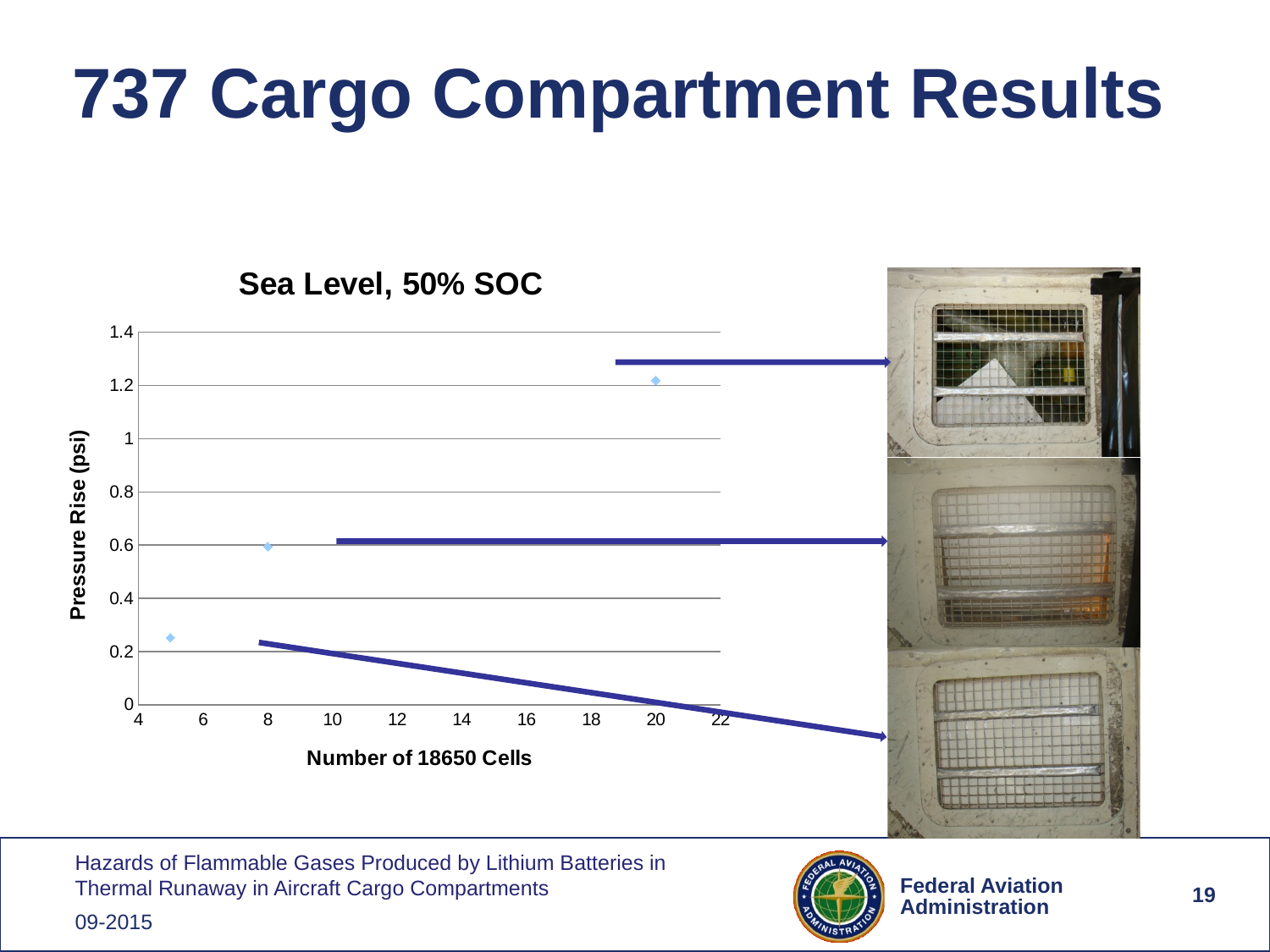
Is the pressure rise at 8 cells greater or less than 0.4 psi? greater What is the label of the y axis of the chart? Pressure Rise (psi) Which point has the lowest pressure rise: the leftmost, middle, or rightmost point? leftmost Is the pressure rise at 8 cells greater or less than 0.8 psi? less Which has the larger pressure rise: 8 cells or 20 cells? 20 cells What is the title of the chart? Sea Level, 50% SOC Is the pressure rise for the leftmost point greater or less than 0.4 psi? less What kind of chart is shown on the slide? scatter chart Does the pressure rise increase or decrease as the number of 18650 cells increases? increase At which number of 18650 cells is the pressure rise highest? 20 How many data points are plotted in the chart? 3